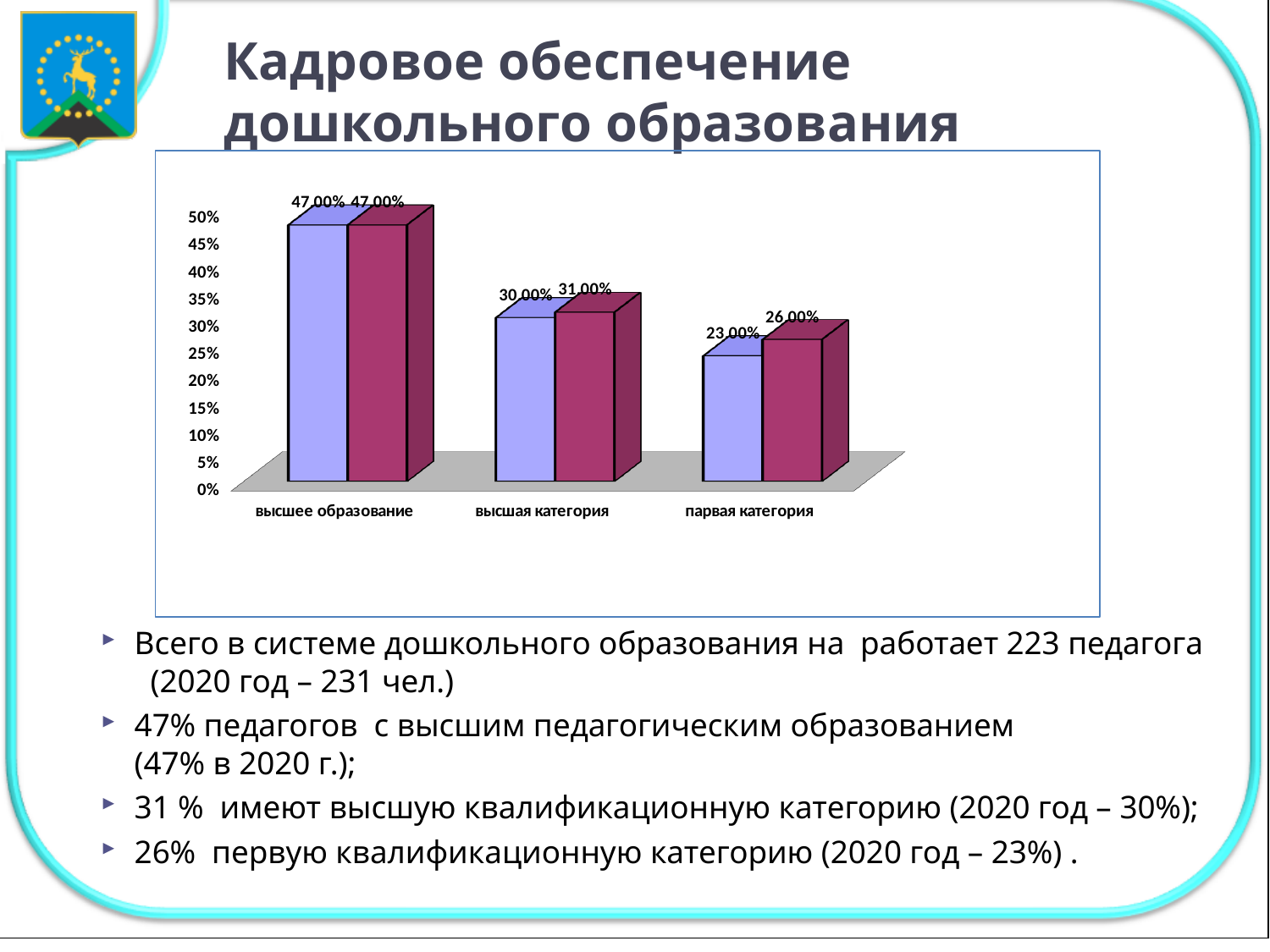
For "высшая категория", which bar is larger, the light blue or the magenta one? magenta How many bars are shown for each category in the chart? 2 Which category has the highest values in the chart? высшее образование What type of chart is shown on the slide? bar chart Do the light blue bar values rise or fall from left to right across the categories? fall What is the difference between the magenta and light blue bars for "парвая категория"? 3.00% What is the value of the light blue bar for "высшее образование"? 47.00% How many categories are shown on the x axis of the chart? 3 What is the value of the light blue bar for "парвая категория"? 23.00% What is the value of the magenta bar for "парвая категория"? 26.00% Which category has the lowest light blue bar? парвая категория What is the value of the magenta bar for "высшая категория"? 31.00%